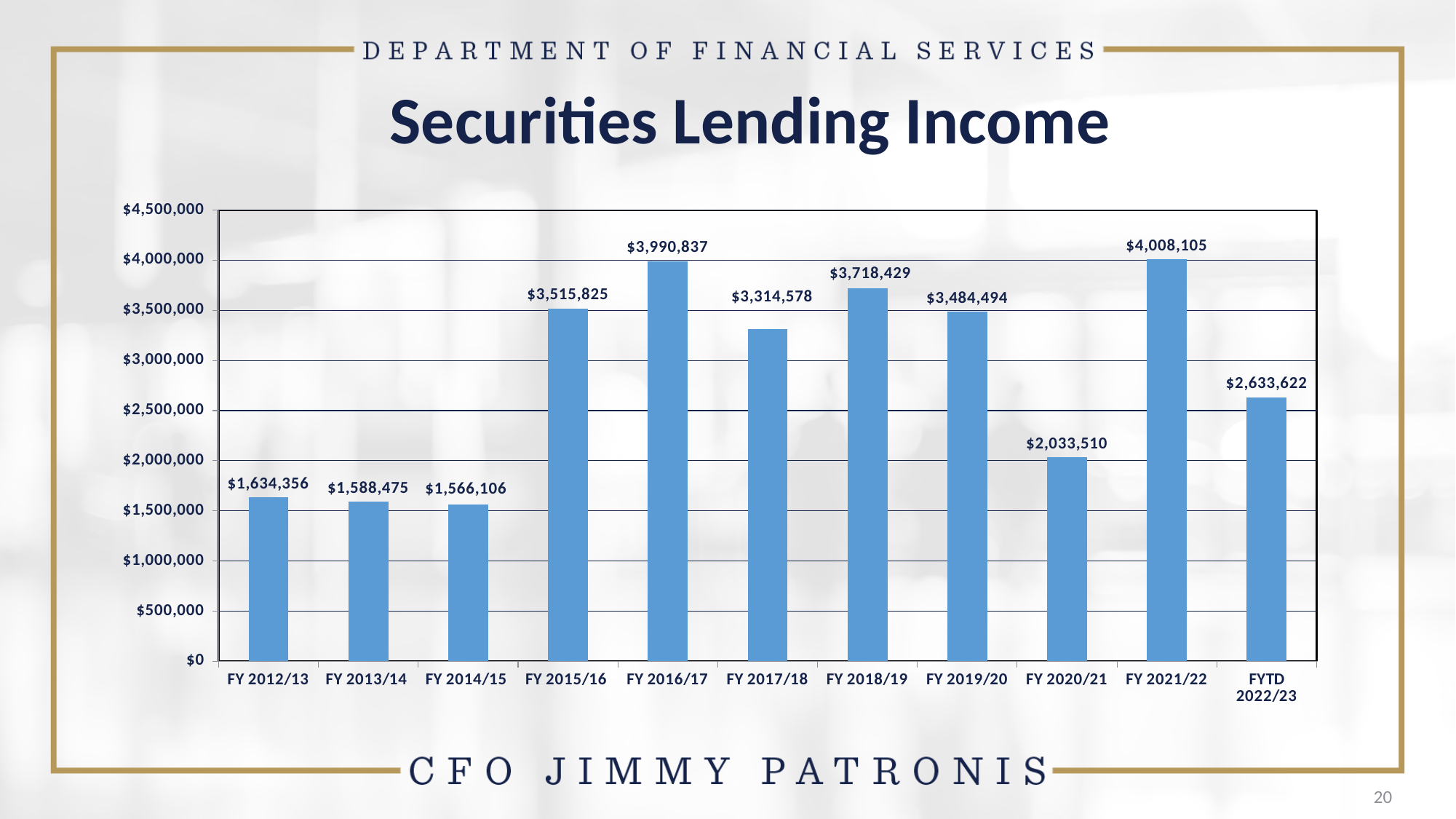
What kind of chart is shown on the slide? bar chart Which fiscal year has the highest Securities Lending Income? FY 2021/22 What is the Securities Lending Income for FY 2016/17? $3,990,837 Which is larger, the Securities Lending Income for FY 2018/19 or FY 2019/20? FY 2018/19 What is the Securities Lending Income for FY 2020/21? $2,033,510 What is the difference between the Securities Lending Income for FY 2015/16 and FY 2014/15? $1,949,719 What is the Securities Lending Income for FYTD 2022/23? $2,633,622 Which fiscal year has the lowest Securities Lending Income? FY 2014/15 How many fiscal years are shown on the chart? 11 What is the difference between the Securities Lending Income for FY 2021/22 and FY 2016/17? $17,268 What is the title of the chart on the slide? Securities Lending Income Is the Securities Lending Income for FY 2017/18 greater or less than $3,000,000? greater